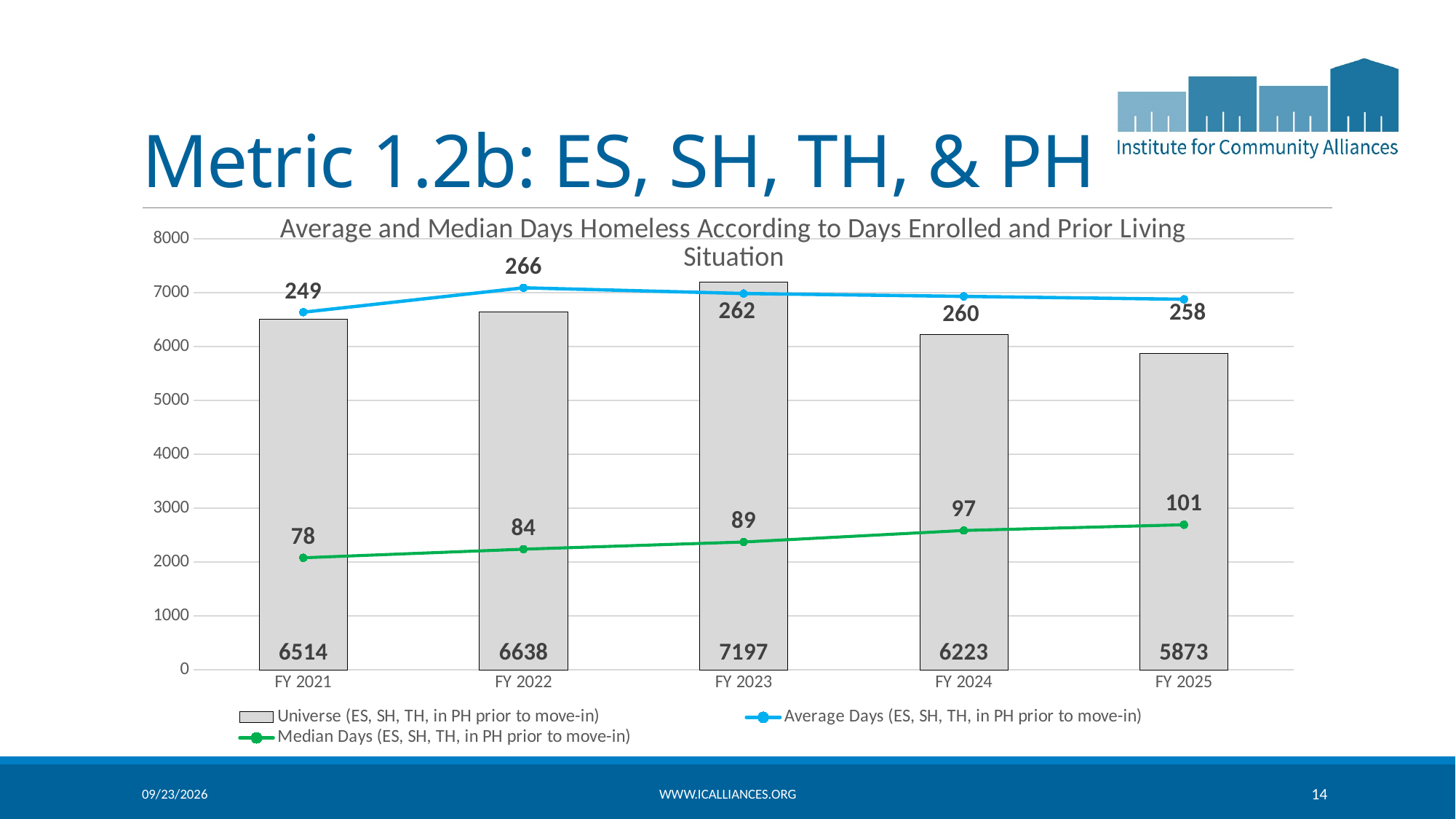
What is the Median Days value for FY 2025? 101 How many series does the legend list? 3 What is the Average Days value for FY 2022? 266 What kind of chart is used for the Universe series? Bar chart What is the difference between the Universe values for FY 2023 and FY 2025? 1324 What is the Universe value for FY 2023? 7197 Which fiscal year has the lowest Universe value? FY 2025 Do the Median Days values rise or fall from FY 2021 to FY 2025? Rise How many fiscal years are shown on the x axis? 5 Which is larger, the Universe value for FY 2021 or FY 2022? FY 2022 What is the title of the chart? Average and Median Days Homeless According to Days Enrolled and Prior Living Situation Which fiscal year has the highest Universe value? FY 2023